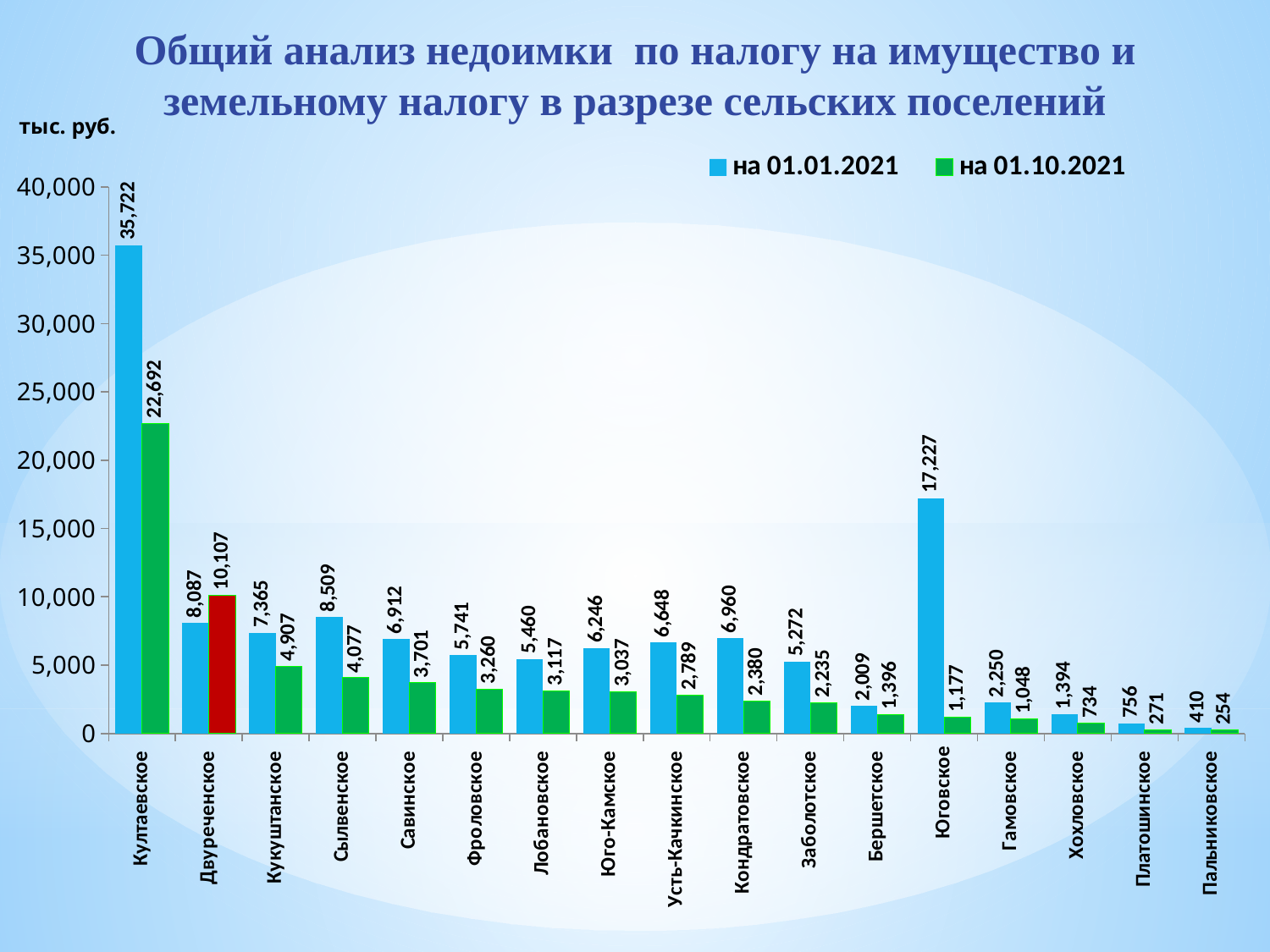
How many series does the legend list? 2 For Двуреченское, which is larger: the value на 01.01.2021 or на 01.10.2021? на 01.10.2021 What is the value for Юговское in the series на 01.10.2021? 1,177 Which bar is coloured red instead of the legend colours? Двуреченское, на 01.10.2021 What kind of chart is shown on the slide? Bar chart Which settlement has the lowest value in the series на 01.10.2021? Пальниковское Which settlement has the highest value in the series на 01.01.2021? Култаевское What is the value for Сылвенское in the series на 01.01.2021? 8,509 What is the difference between the на 01.01.2021 and на 01.10.2021 values for Юговское? 16,050 What is the value for Култаевское in the series на 01.01.2021? 35,722 How many settlements are shown on the x axis? 17 What is the difference between the на 01.01.2021 and на 01.10.2021 values for Култаевское? 13,030